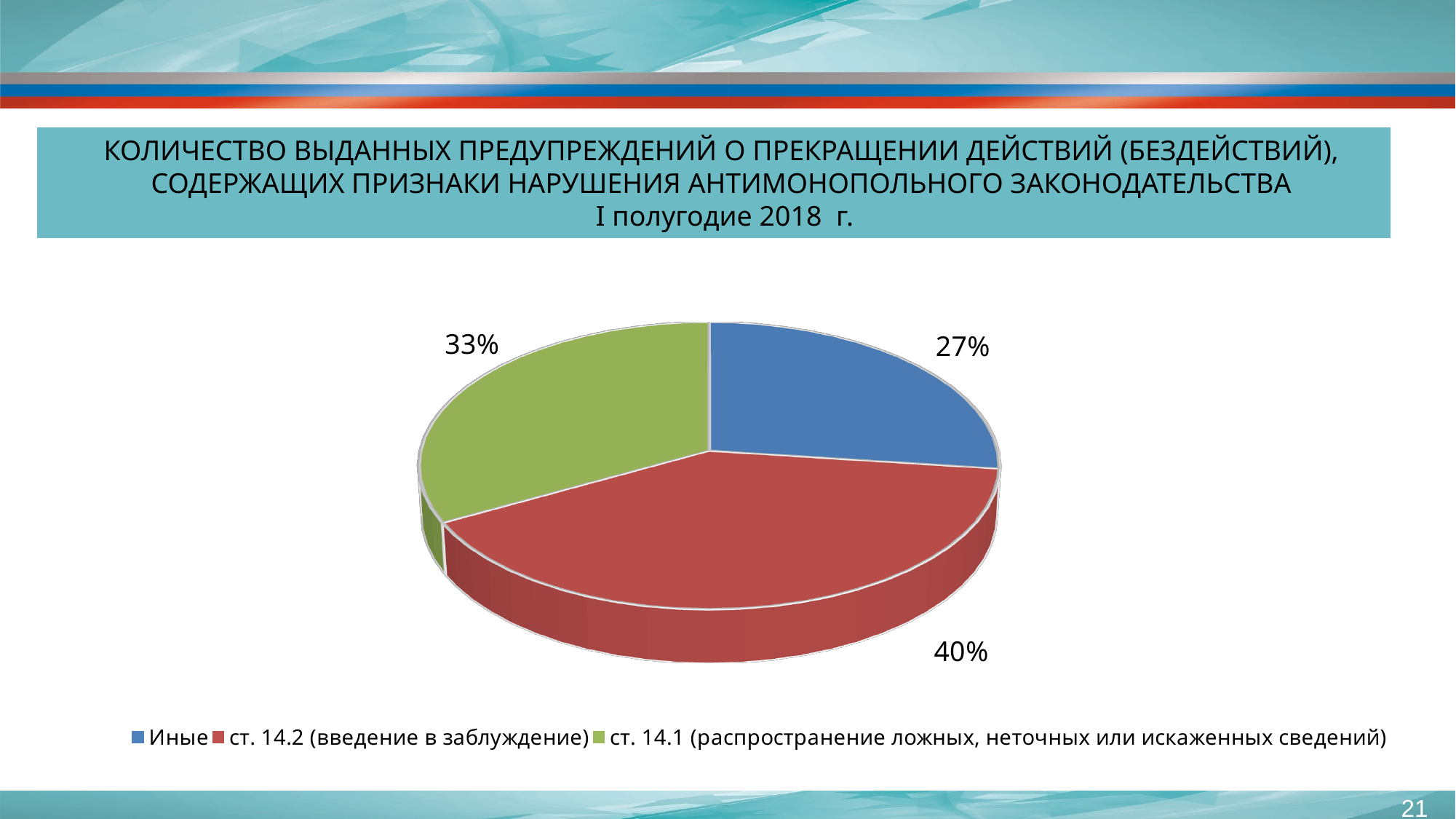
Which slice is larger: «ст. 14.1 (распространение ложных, неточных или искаженных сведений)» or «Иные»? ст. 14.1 (распространение ложных, неточных или искаженных сведений) What kind of chart is shown on the slide? Pie chart How many slices does the pie chart have? 3 Which category has the largest slice of the pie? ст. 14.2 (введение в заблуждение) What share of the pie does the slice for «ст. 14.2 (введение в заблуждение)» represent? 40% What share of the pie does the slice for «ст. 14.1 (распространение ложных, неточных или искаженных сведений)» represent? 33% Which period does the chart title refer to? I полугодие 2018 г. How many entries does the legend list? 3 What share of the pie does the slice for «Иные» represent? 27% What is the difference in percentage points between the slice for «ст. 14.2 (введение в заблуждение)» and the slice for «Иные»? 13 Which category has the smallest slice of the pie? Иные What colour is the slice for «ст. 14.2 (введение в заблуждение)»? Red